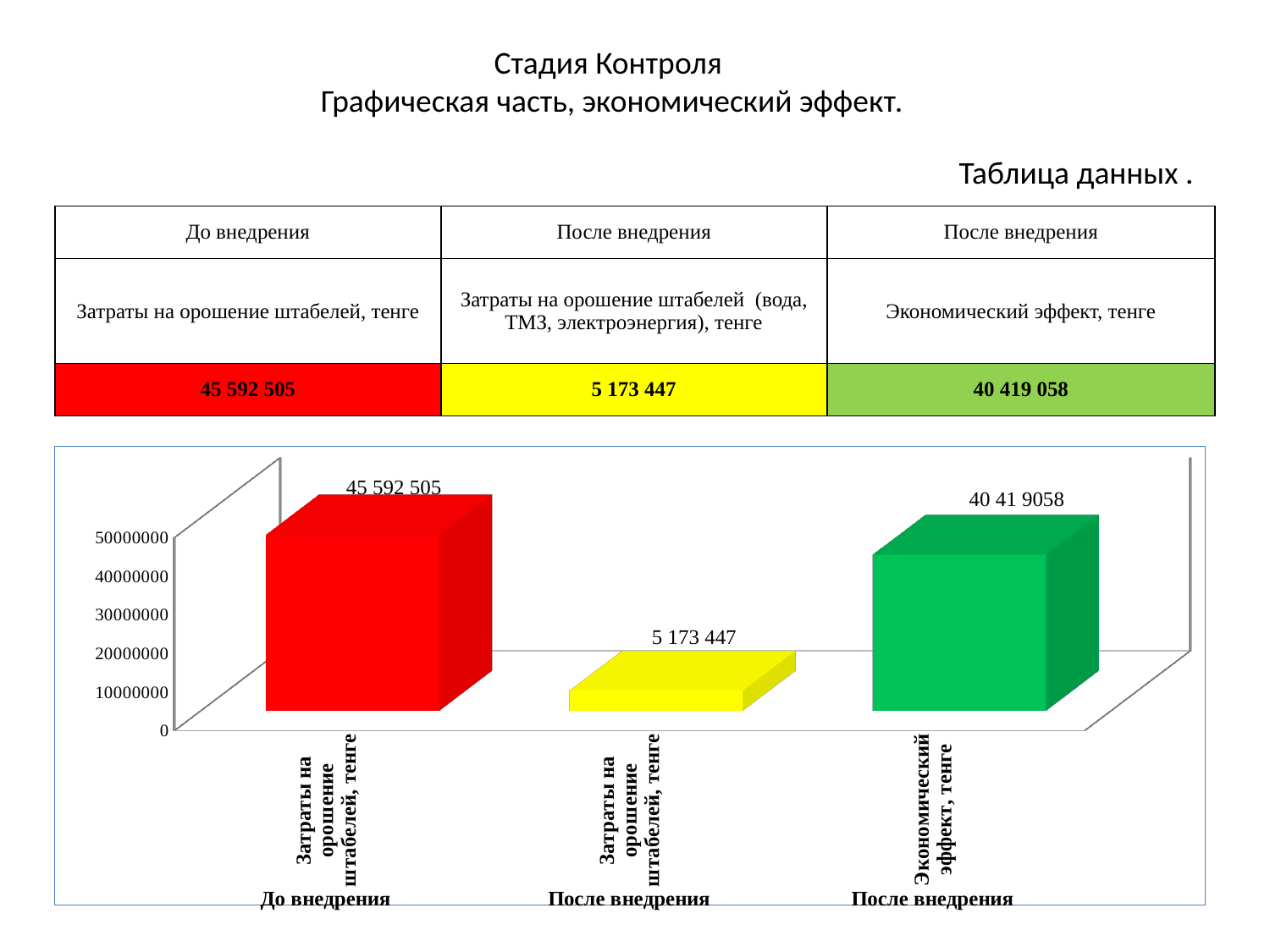
Is the value of the 'Затраты на орошение штабелей' bar under 'После внедрения' greater or less than 10000000? less Is the value of the 'Экономический эффект, тенге' bar greater or less than 30000000? greater How many bars are plotted in the chart? 3 What colour is the bar for 'Экономический эффект, тенге'? green What colour is the bar for 'До внедрения'? red Which bar in the chart is the lowest? Затраты на орошение штабелей, тенге (После внедрения) What type of chart is shown on the slide? bar chart What is the difference between the 'Затраты на орошение штабелей' bar before implementation (До внедрения) and after implementation (После внедрения)? 40 419 058 What is the value of the bar for 'Затраты на орошение штабелей, тенге' under 'До внедрения'? 45 592 505 Which is larger: the 'Затраты на орошение штабелей' bar under 'До внедрения' or the 'Экономический эффект' bar? Затраты на орошение штабелей (До внедрения) Which bar in the chart is the highest? Затраты на орошение штабелей, тенге (До внедрения) What is the value of the bar for 'Затраты на орошение штабелей, тенге' under 'После внедрения'? 5 173 447